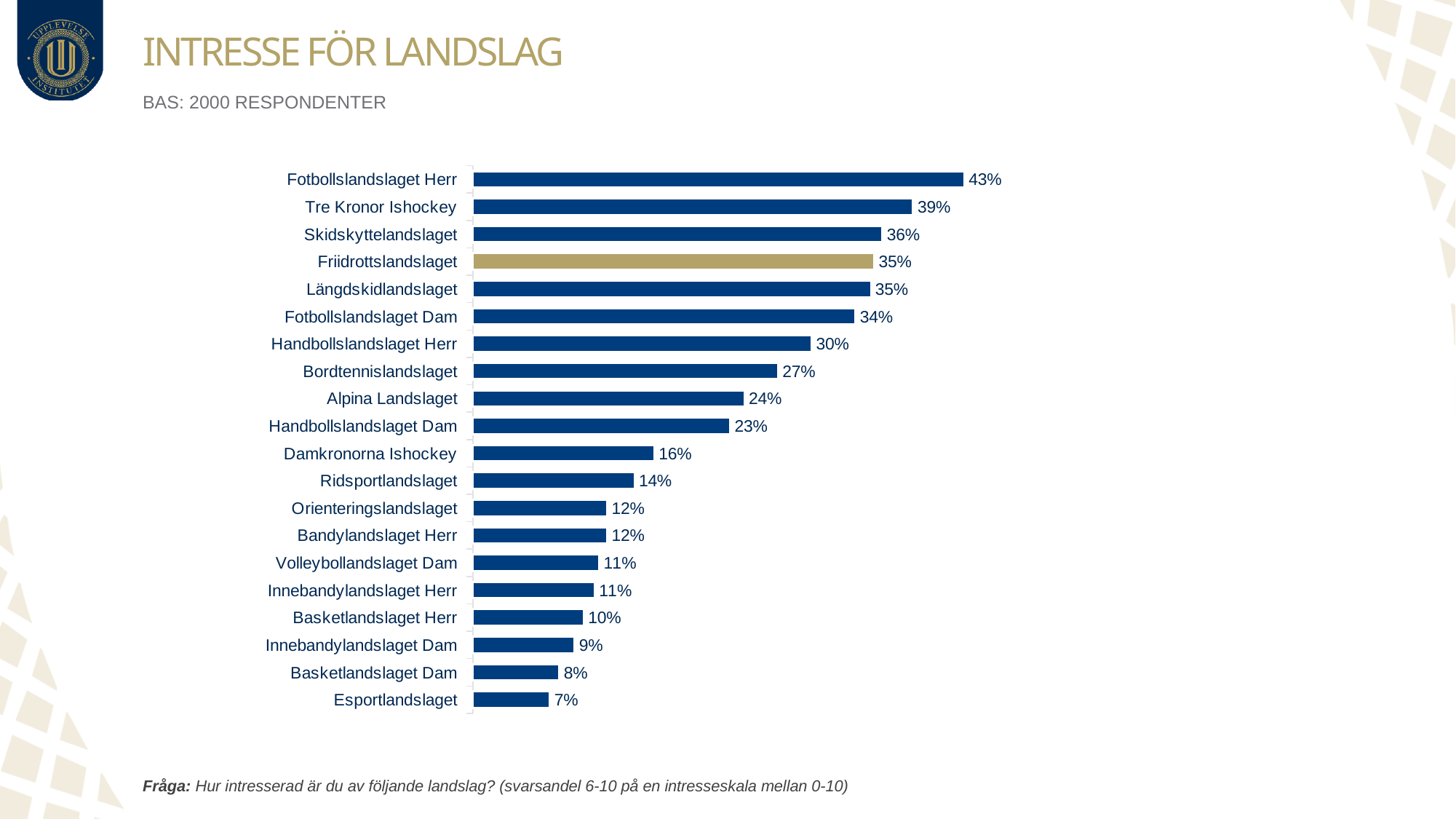
How many categories are shown in the chart? 20 What is the value for Fotbollslandslaget Herr? 43% Which category's bar is shown in a gold colour instead of blue? Friidrottslandslaget Which is larger, Basketlandslaget Herr or Basketlandslaget Dam? Basketlandslaget Herr What is the value for Handbollslandslaget Dam? 23% Which category has the highest value? Fotbollslandslaget Herr Which category has the lowest value? Esportlandslaget What is the difference between Tre Kronor Ishockey and Damkronorna Ishockey? 23% What kind of chart is shown on the slide? Bar chart Which is larger, Bordtennislandslaget or Alpina Landslaget? Bordtennislandslaget What is the value for Esportlandslaget? 7% What is the difference between Fotbollslandslaget Herr and Fotbollslandslaget Dam? 9%